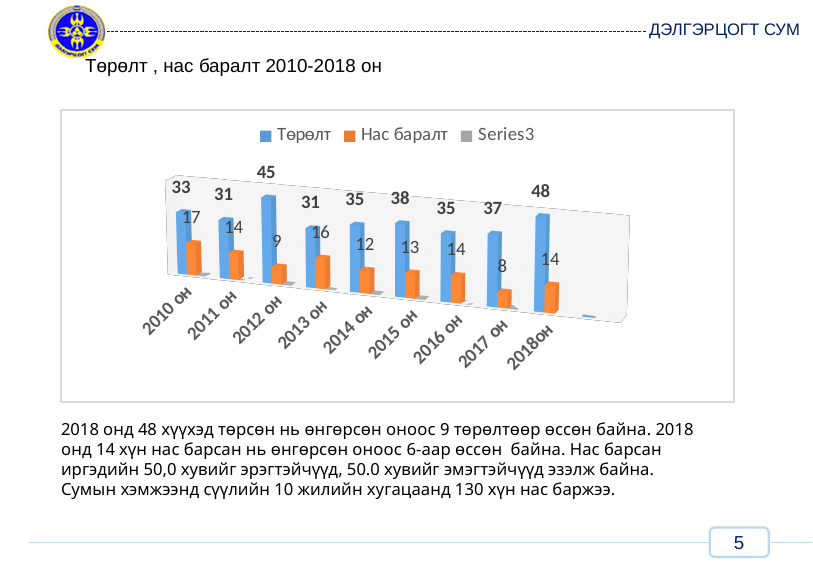
What type of chart is shown on the slide? bar chart How many year categories are shown on the x axis of the chart? 9 Which year has the highest Төрөлт value? 2018он What is the Төрөлт value for 2012 он? 45 What is the Төрөлт value for 2018он? 48 Which year has the lowest Нас баралт value? 2017 он What is the Нас баралт value for 2017 он? 8 What is the difference between the Төрөлт and Нас баралт values for 2010 он? 16 Which is larger, the Нас баралт value for 2013 он or for 2014 он? 2013 он What is the difference between the Төрөлт values for 2018он and 2017 он? 11 What colour are the Нас баралт bars in the chart? orange How many series does the chart legend list? 3